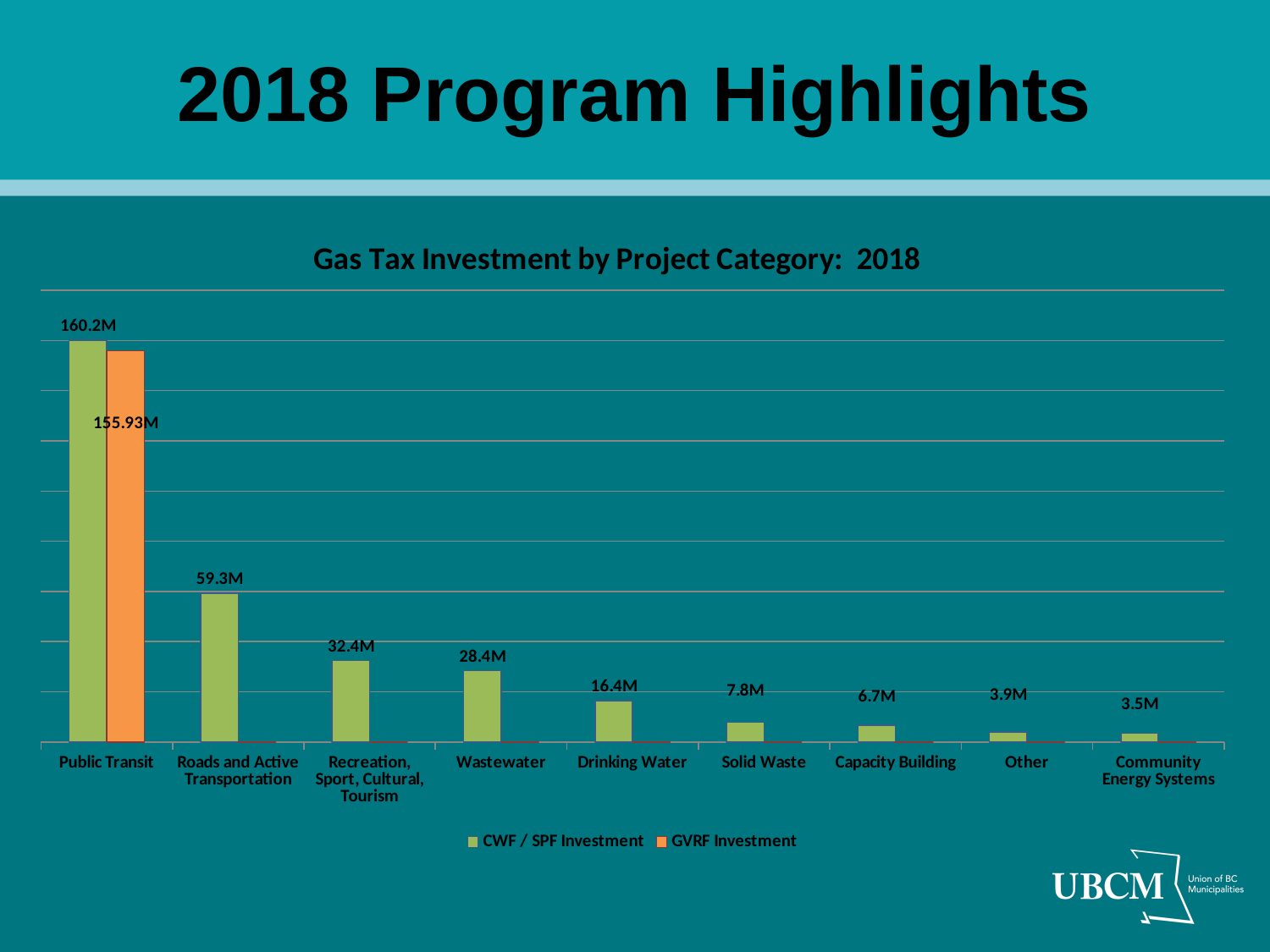
What is the GVRF Investment value for Public Transit? 155.93M What kind of chart is shown on the slide? Bar chart What is the CWF / SPF Investment value for Roads and Active Transportation? 59.3M Which project category has the lowest CWF / SPF Investment? Community Energy Systems How many project categories are shown on the x axis? 9 How many series does the legend list? 2 Which project category has the highest CWF / SPF Investment? Public Transit Which has a larger CWF / SPF Investment, Drinking Water or Solid Waste? Drinking Water What is the CWF / SPF Investment value for Wastewater? 28.4M What is the CWF / SPF Investment value for Public Transit? 160.2M What is the difference between the CWF / SPF Investment and the GVRF Investment for Public Transit? 4.25M What is the difference in CWF / SPF Investment between Roads and Active Transportation and Recreation, Sport, Cultural, Tourism? 26.9M